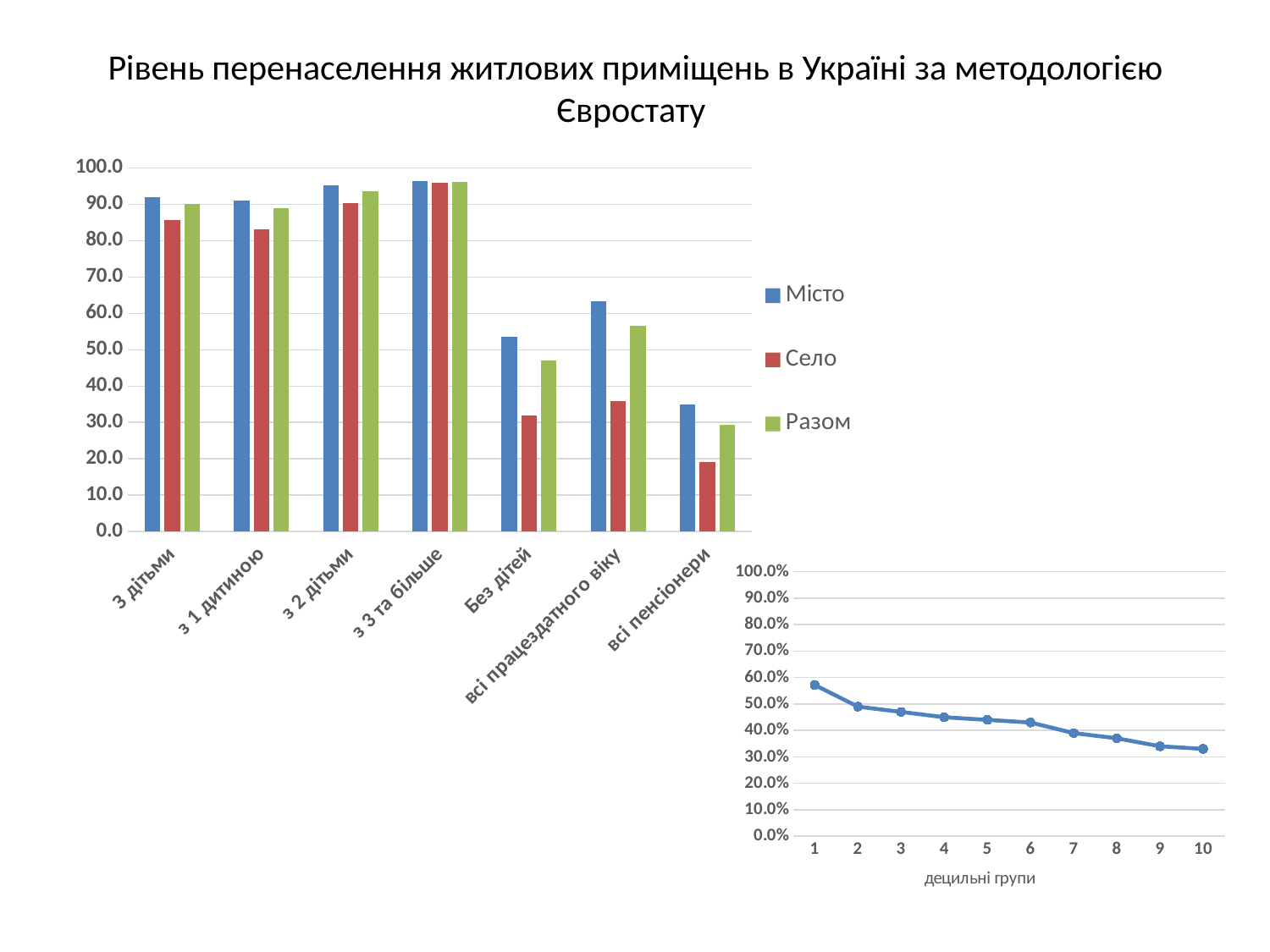
What kind of chart is the chart on the left of the slide? bar chart In the line chart in the bottom right, how many decile groups are plotted on the x axis? 10 In the line chart in the bottom right, do the values rise or fall as the decile group increases from 1 to 10? fall In the bar chart on the left, which category has the highest value for Місто? з 3 та більше What kind of chart is the chart in the bottom right of the slide? line chart In the bar chart on the left, which category has the lowest value for Село? всі пенсіонери In the bar chart on the left, how many categories are shown on the x axis? 7 In the bar chart on the left, which is larger for the category 'всі пенсіонери': Місто or Село? Місто In the bar chart on the left, is the value for Місто in the category 'всі працездатного віку' greater or less than 60.0? greater In the bar chart on the left, is the value for Село in the category 'Без дітей' greater or less than 40.0? less In the bar chart on the left, how many series does the legend list? 3 In the line chart in the bottom right, is the value for decile group 1 greater or less than 50.0%? greater